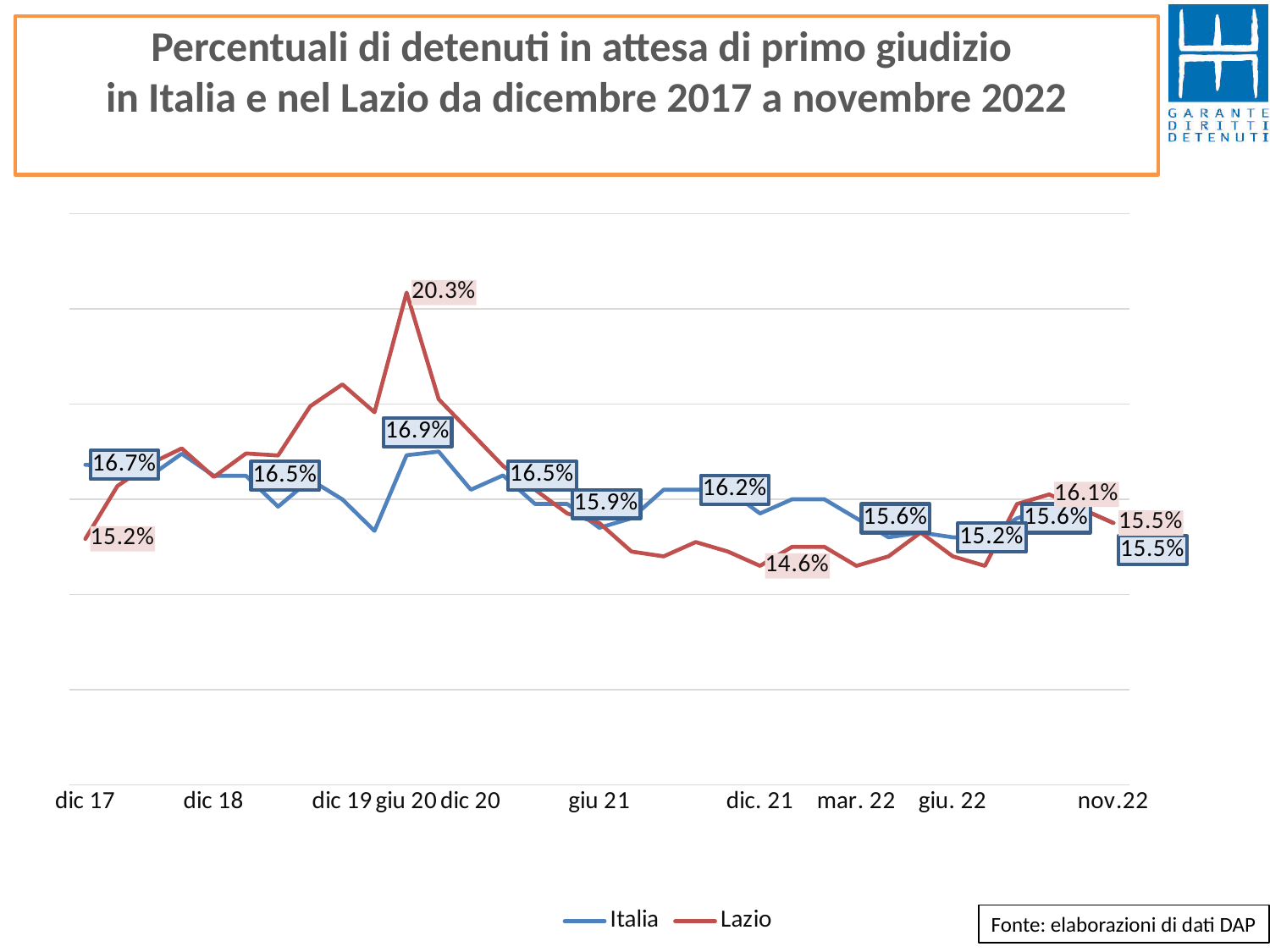
What is the value for Lazio at nov.22? 15.5% What is the value for Lazio at dic 17? 15.2% What is the value for Italia at dic 17? 16.7% What is the lowest labelled value for Lazio? 14.6% What is the value for Italia at nov.22? 15.5% What is the highest labelled value for Lazio? 20.3% What is the difference between the Italia and Lazio values at dic 17? 1.5 percentage points What is the value for Lazio at giu 20? 20.3% What are the two series named in the legend? Italia and Lazio At dic 17, which series has the higher value, Italia or Lazio? Italia How many series does the legend list? 2 What kind of chart is shown on the slide? line chart